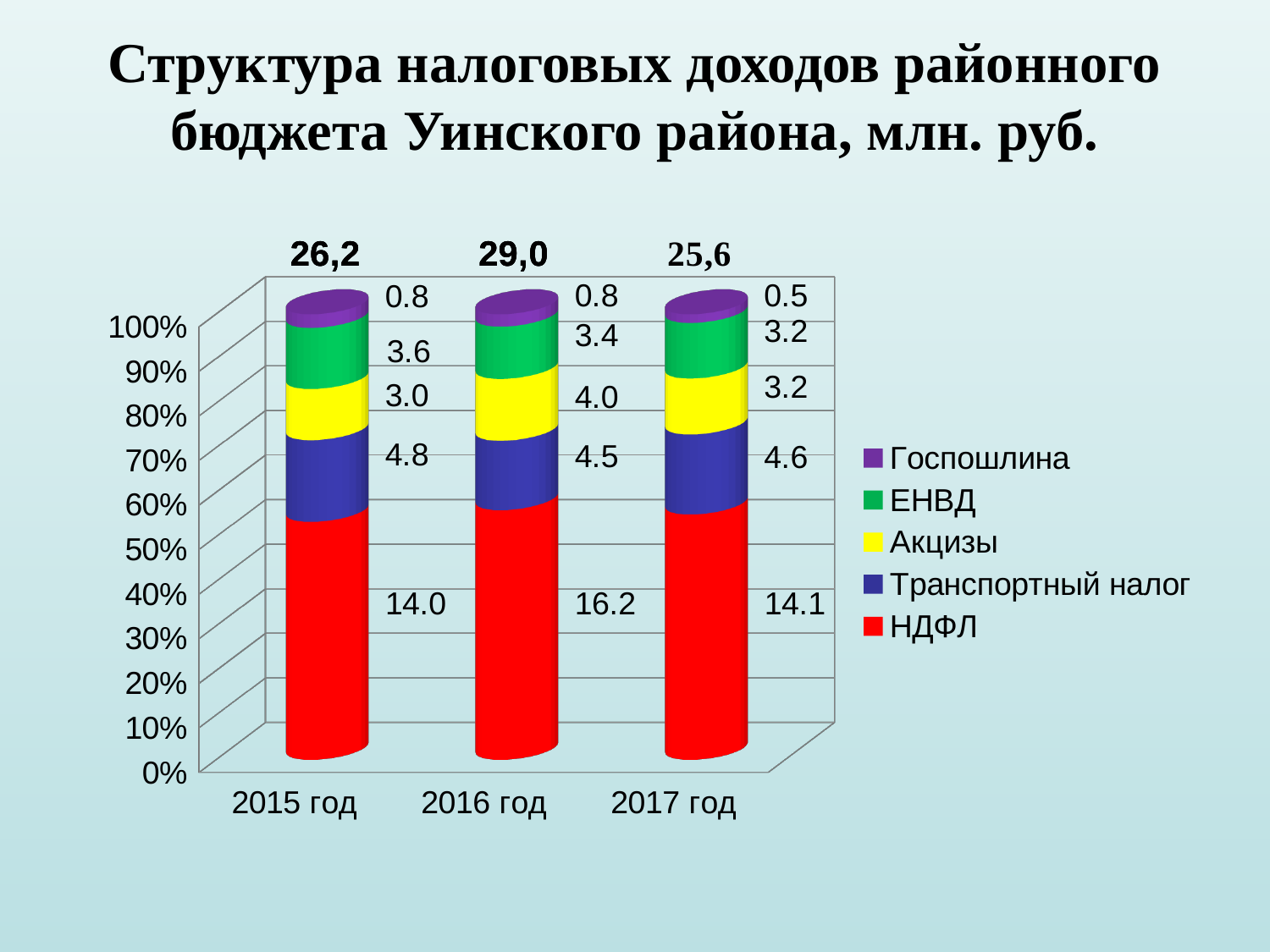
What kind of chart is shown on the slide? Stacked bar chart What is the total shown above the bar for 2016 год? 29,0 What is the difference between the НДФЛ values for 2016 год and 2015 год? 2.2 What is the value of Госпошлина for 2017 год? 0.5 What is the value of Транспортный налог for 2015 год? 4.8 Which is larger, the Акцизы value for 2016 год or for 2015 год? 2016 год Which year has the highest value for НДФЛ? 2016 год How many years are shown on the x axis? 3 What is the value of Акцизы for 2017 год? 3.2 What is the value of НДФЛ for 2016 год? 16.2 How many series does the legend list? 5 Which year has the lowest value for Госпошлина? 2017 год